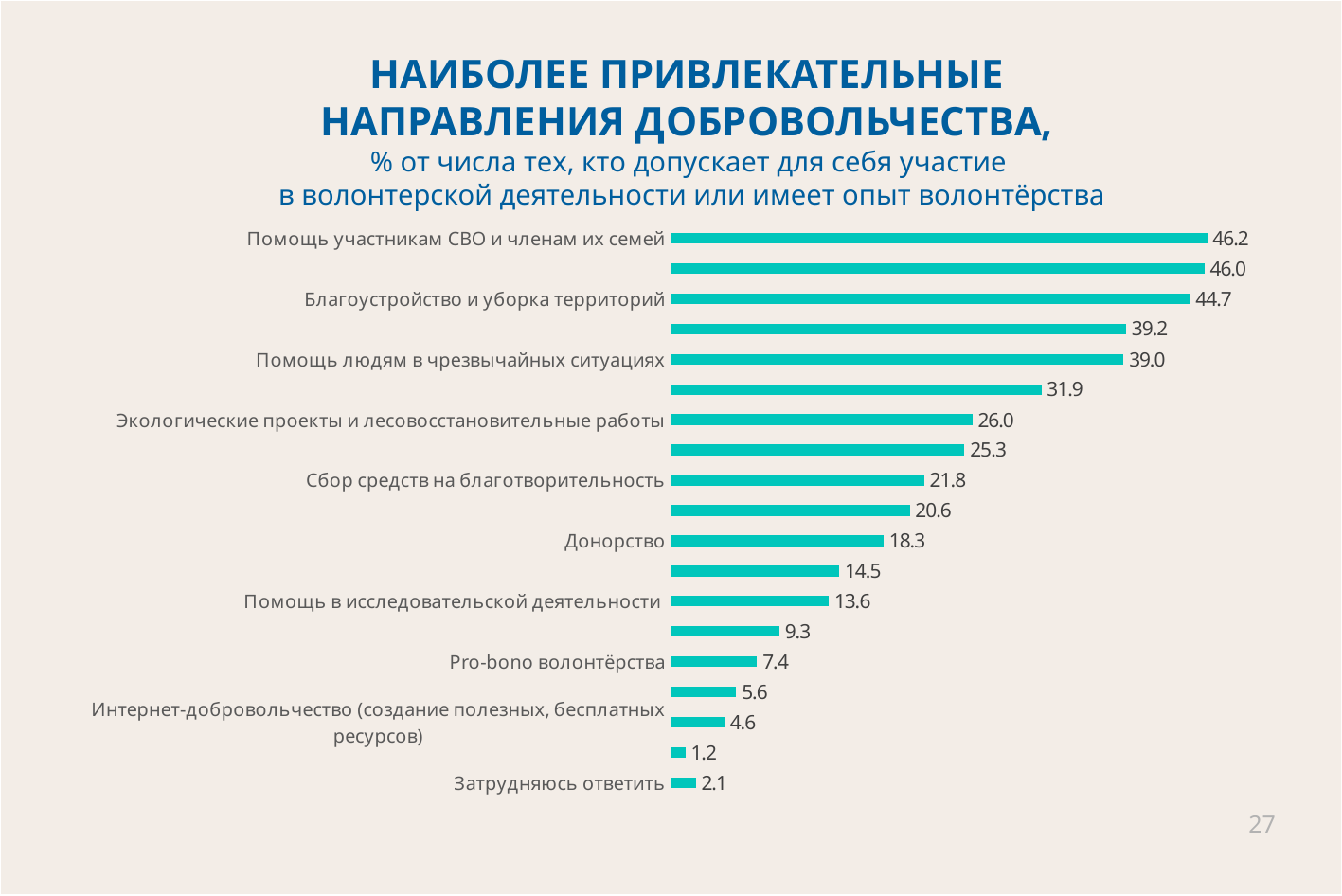
What is the difference between «Помощь людям в чрезвычайных ситуациях» and «Экологические проекты и лесовосстановительные работы»? 13.0 What is the value for «Благоустройство и уборка территорий»? 44.7 What is the value for «Помощь участникам СВО и членам их семей»? 46.2 Which is larger: «Сбор средств на благотворительность» or «Донорство»? Сбор средств на благотворительность What is the value for «Помощь людям в чрезвычайных ситуациях»? 39.0 What is the value for «Pro-bono волонтёрства»? 7.4 What kind of chart is shown on the slide? Bar chart What is the value for «Затрудняюсь ответить»? 2.1 Which labelled category has the highest value? Помощь участникам СВО и членам их семей What is the smallest value shown on the chart? 1.2 What is the value for «Донорство»? 18.3 How many bars are plotted on the chart? 19